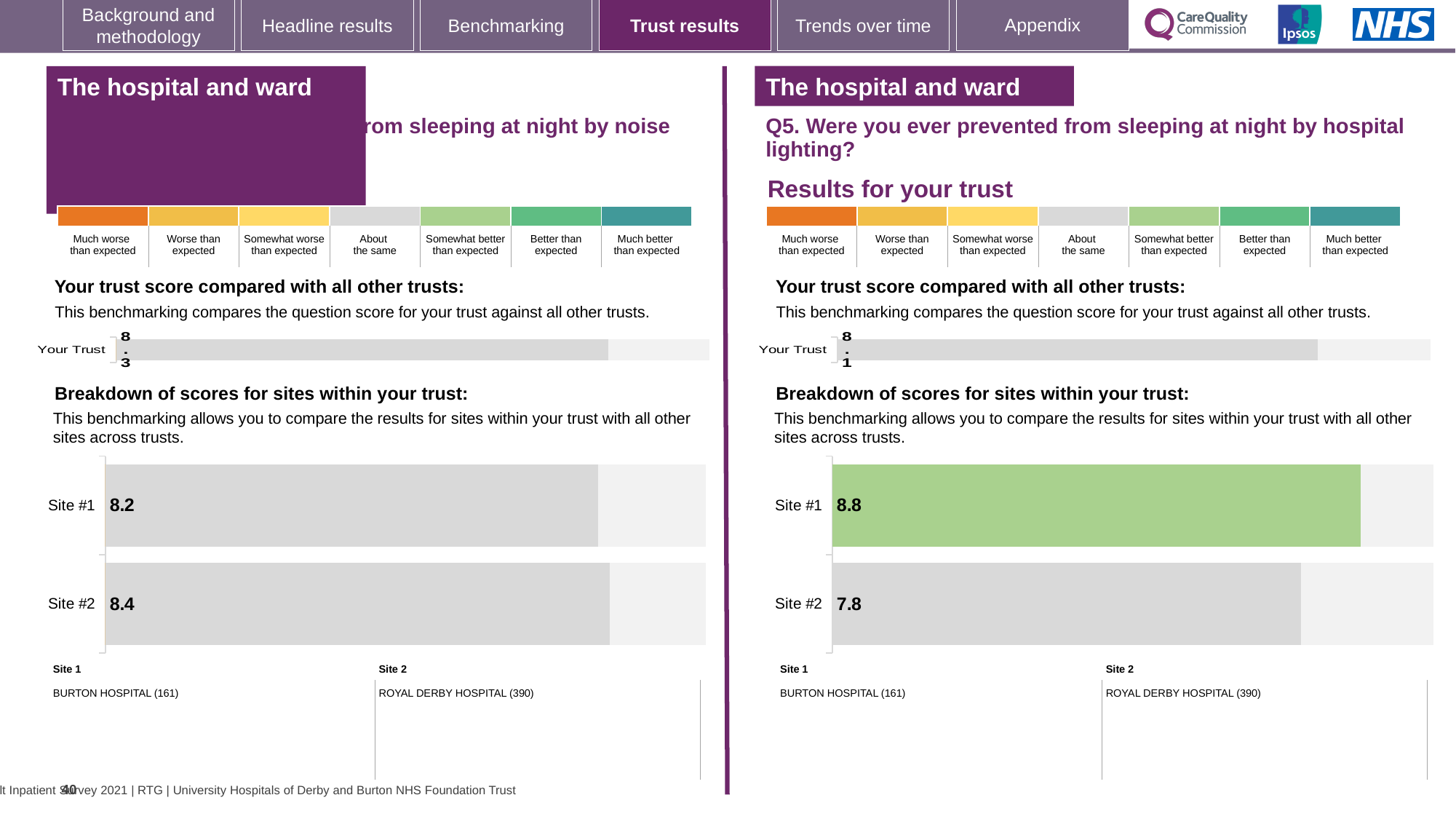
In the right-hand site breakdown chart (Q5, hospital lighting), what is the score for Site #2? 7.8 How many sites are shown in the right-hand site breakdown chart (Q5, hospital lighting)? 2 In the left-hand site breakdown chart (sleeping at night by noise), what is the score for Site #1? 8.2 What type of chart is used for the site breakdown on the right-hand slide section (Q5, hospital lighting)? Bar chart In the left-hand site breakdown chart (sleeping at night by noise), what is the score for Site #2? 8.4 On the right-hand slide section (Q5, hospital lighting), what is the score shown for Your Trust? 8.1 In the right-hand site breakdown chart (Q5, hospital lighting), what is the difference between the Site #1 and Site #2 scores? 1.0 On the left-hand slide section (sleeping at night by noise), what is the score shown for Your Trust? 8.3 In the left-hand site breakdown chart (sleeping at night by noise), what is the difference between the Site #2 and Site #1 scores? 0.2 In the left-hand site breakdown chart (sleeping at night by noise), which site has the lower score? Site #1 In the right-hand site breakdown chart (Q5, hospital lighting), what is the score for Site #1? 8.8 In the right-hand site breakdown chart (Q5, hospital lighting), which site has the higher score? Site #1